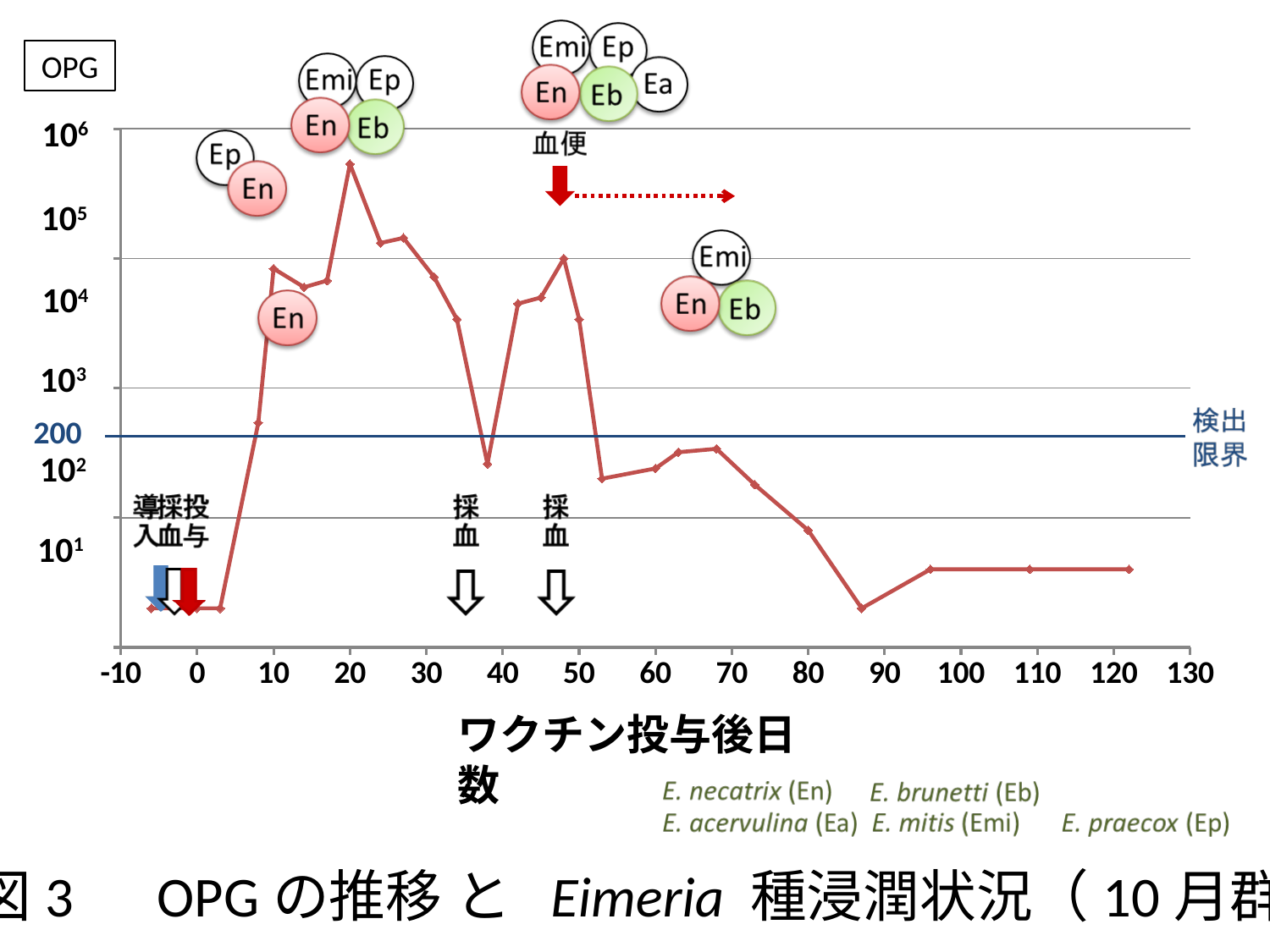
Between day 53 and day 87, does the OPG value rise or fall? fall Is the OPG value at day 20 greater or less than 10^5? greater Is the OPG value at day 87 greater or less than 10^1? less What kind of chart is shown on the slide? line chart What value is marked by the horizontal line labelled 検出限界 (detection limit)? 200 Between day 0 and day 20, does the OPG value rise or fall? rise Is the OPG value at day 48 greater or less than 10^4? greater Which has the higher OPG value, day 20 or day 48? day 20 Which has the higher OPG value, day 10 or day 60? day 10 At which day after vaccine administration does the OPG reach its highest value? 20 What is the title of the x axis of the chart? ワクチン投与後日数